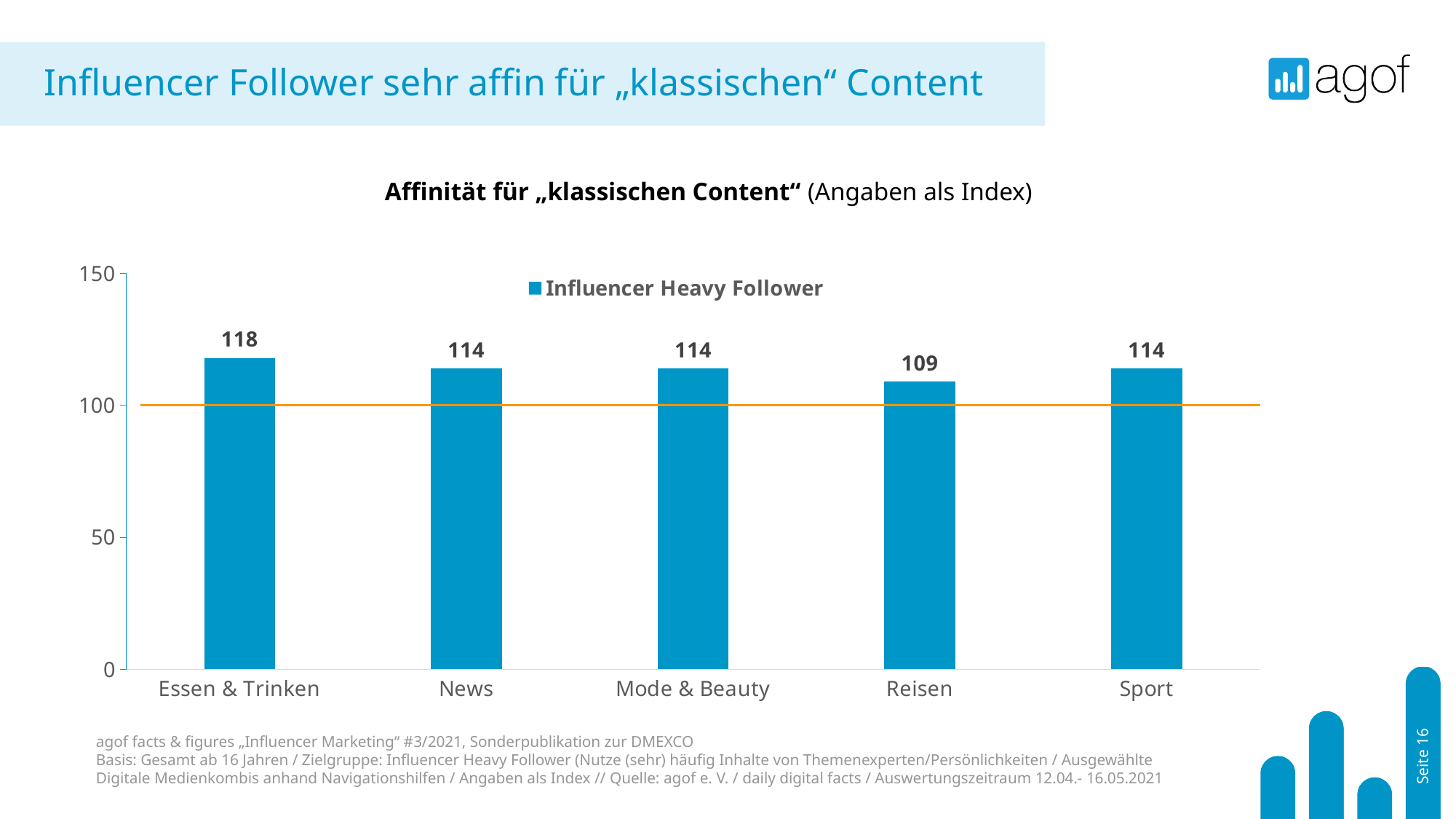
Which category has the highest index value? Essen & Trinken What is the difference between the index values for Essen & Trinken and Reisen? 9 What is the index value for Reisen? 109 How many series does the legend list? 1 What kind of chart is shown on the slide? bar chart How many categories are shown on the x axis? 5 What series name is shown in the legend? Influencer Heavy Follower What is the index value for Sport? 114 What is the index value for Essen & Trinken? 118 Which category has the lowest index value? Reisen Is the value for Mode & Beauty greater or less than 100? greater Which has a higher index value, News or Reisen? News